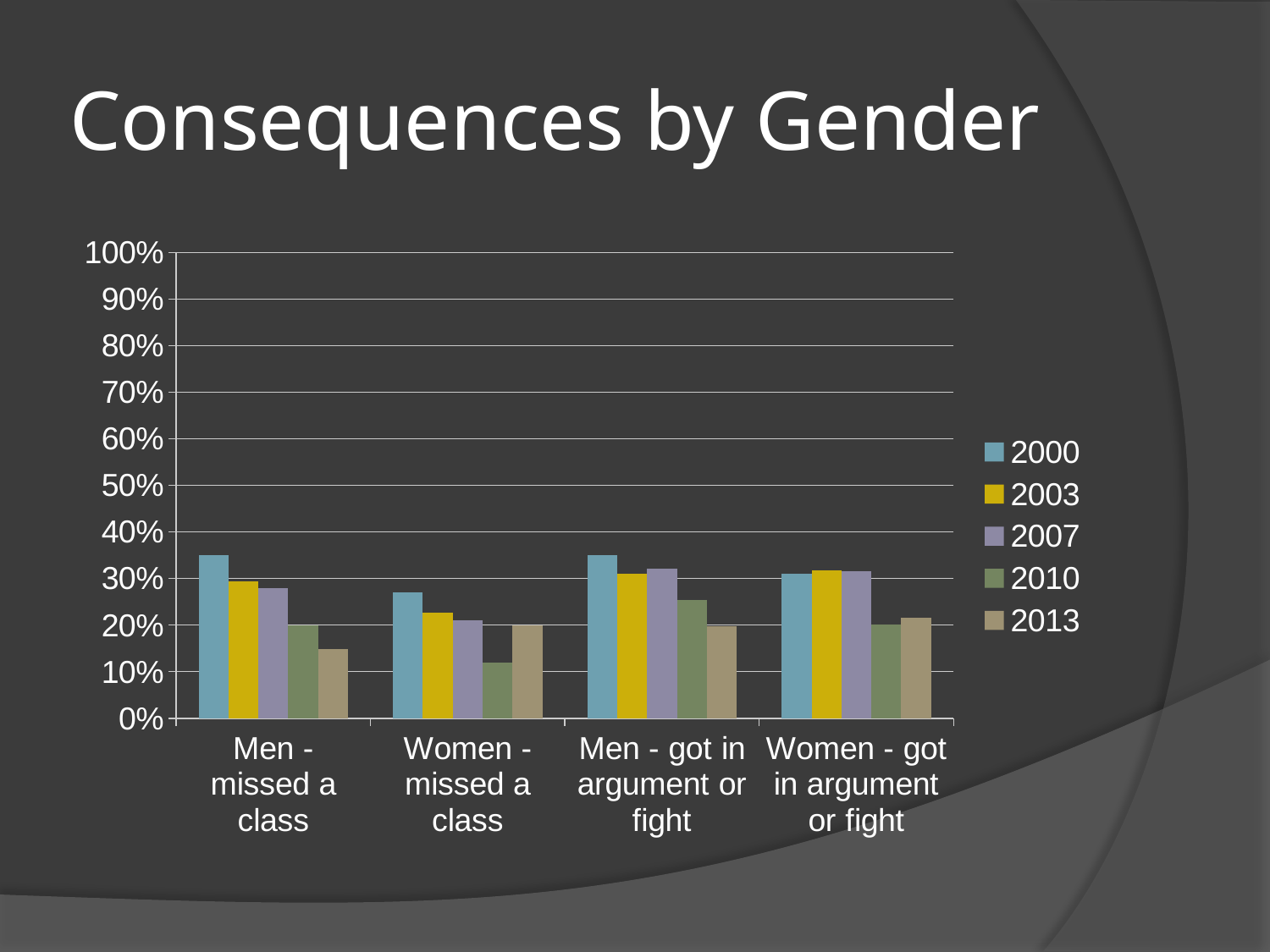
How many categories are shown on the x axis? 4 Is the value for 2010 in the 'Women - missed a class' category greater or less than 20%? less In the 'Men - missed a class' category, which is larger: the value for 2000 or the value for 2013? 2000 What is the title of the slide? Consequences by Gender In the 'Men - missed a class' category, which year has the lowest value? 2013 In the 'Men - missed a class' category, do the values rise or fall from 2000 to 2013? Fall In the 'Women - missed a class' category, which year has the lowest value? 2010 Is the value for 2013 in the 'Men - missed a class' category greater or less than 20%? less Is the value for 2010 in the 'Men - got in argument or fight' category greater or less than 20%? greater What kind of chart is shown on the slide? Bar chart How many series does the legend list? 5